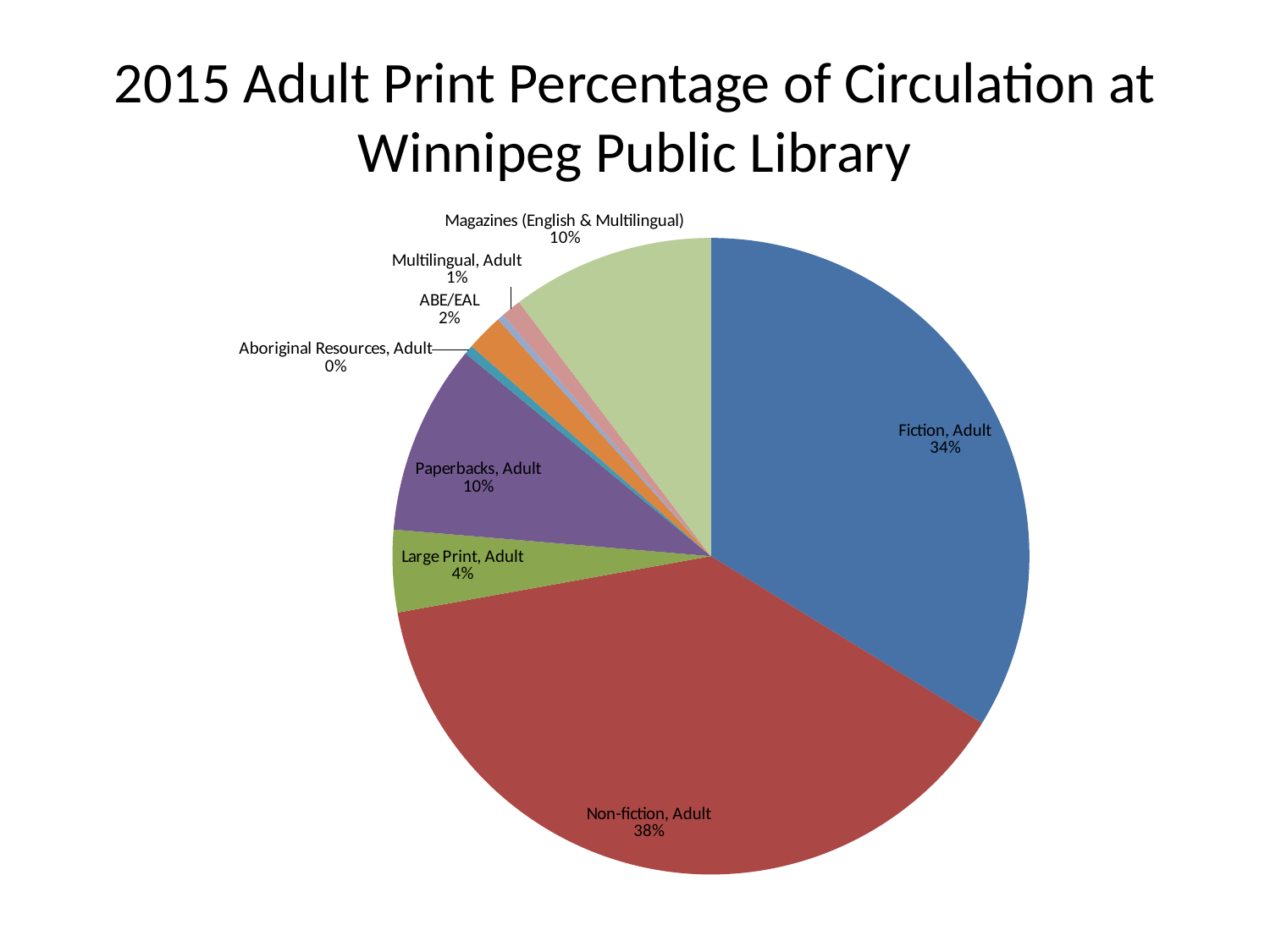
What is the difference in percentage points between Non-fiction, Adult and Fiction, Adult? 4 What percentage of circulation is Magazines (English & Multilingual)? 10% Which has a larger share of circulation, Paperbacks, Adult or Large Print, Adult? Paperbacks, Adult What percentage of circulation is Non-fiction, Adult? 38% What kind of chart is shown on the slide? Pie chart How many categories are shown in the pie chart? 9 What percentage of circulation is Large Print, Adult? 4% What is the title of the chart? 2015 Adult Print Percentage of Circulation at Winnipeg Public Library What percentage of circulation is Fiction, Adult? 34% What percentage of circulation is ABE/EAL? 2% Which category has the largest share of circulation? Non-fiction, Adult